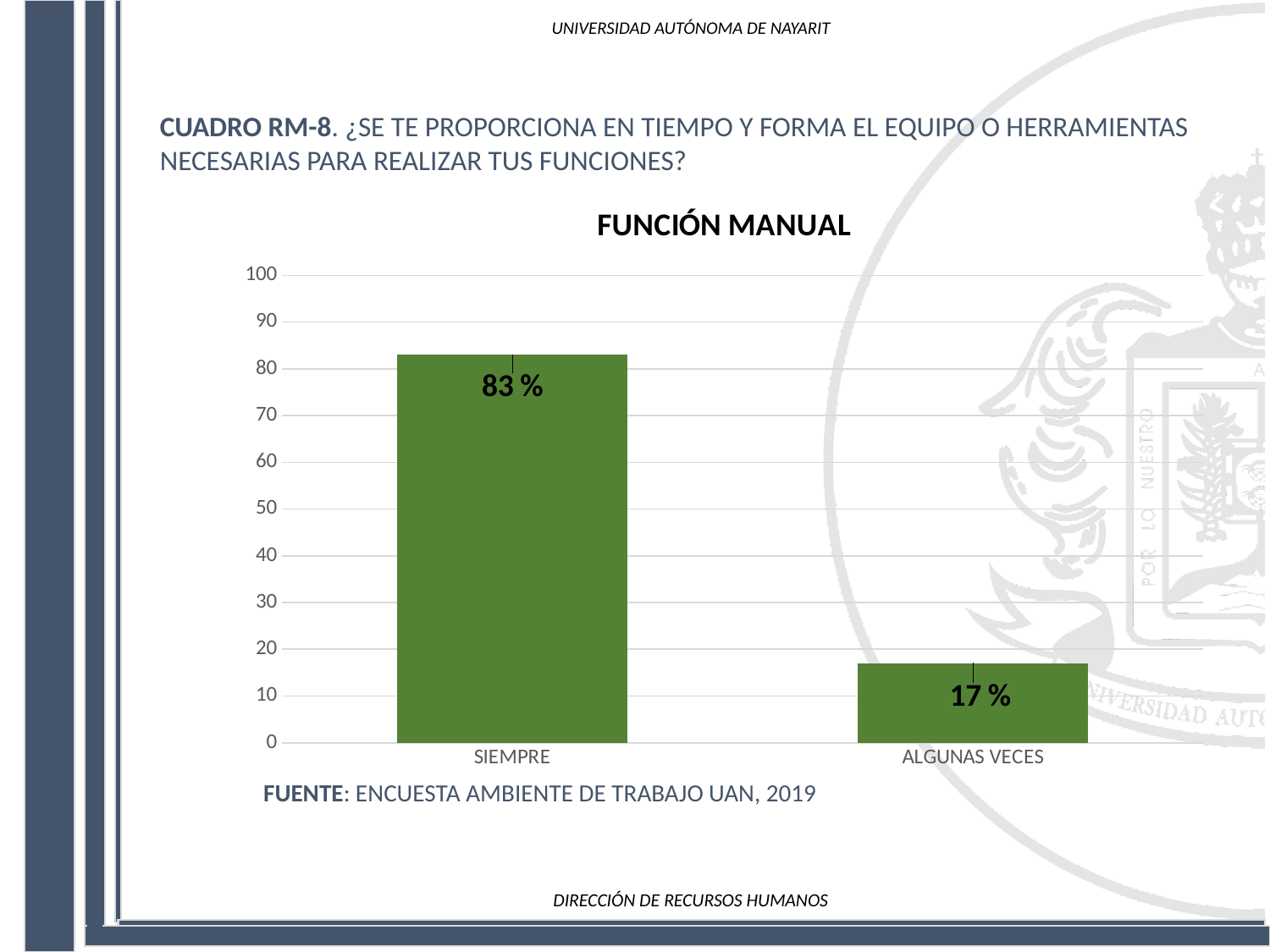
Which category has the highest value? SIEMPRE What is the difference between the values for SIEMPRE and ALGUNAS VECES? 66 % Is the value for SIEMPRE greater or less than 80? greater What kind of chart is shown on the slide? bar chart Is the value for ALGUNAS VECES greater or less than 20? less How many categories are shown on the x axis? 2 Which is larger, the value for SIEMPRE or the value for ALGUNAS VECES? SIEMPRE What is the maximum value shown on the vertical axis? 100 What is the title of the chart? FUNCIÓN MANUAL What is the value for SIEMPRE? 83 % What is the value for ALGUNAS VECES? 17 % Which category has the lowest value? ALGUNAS VECES